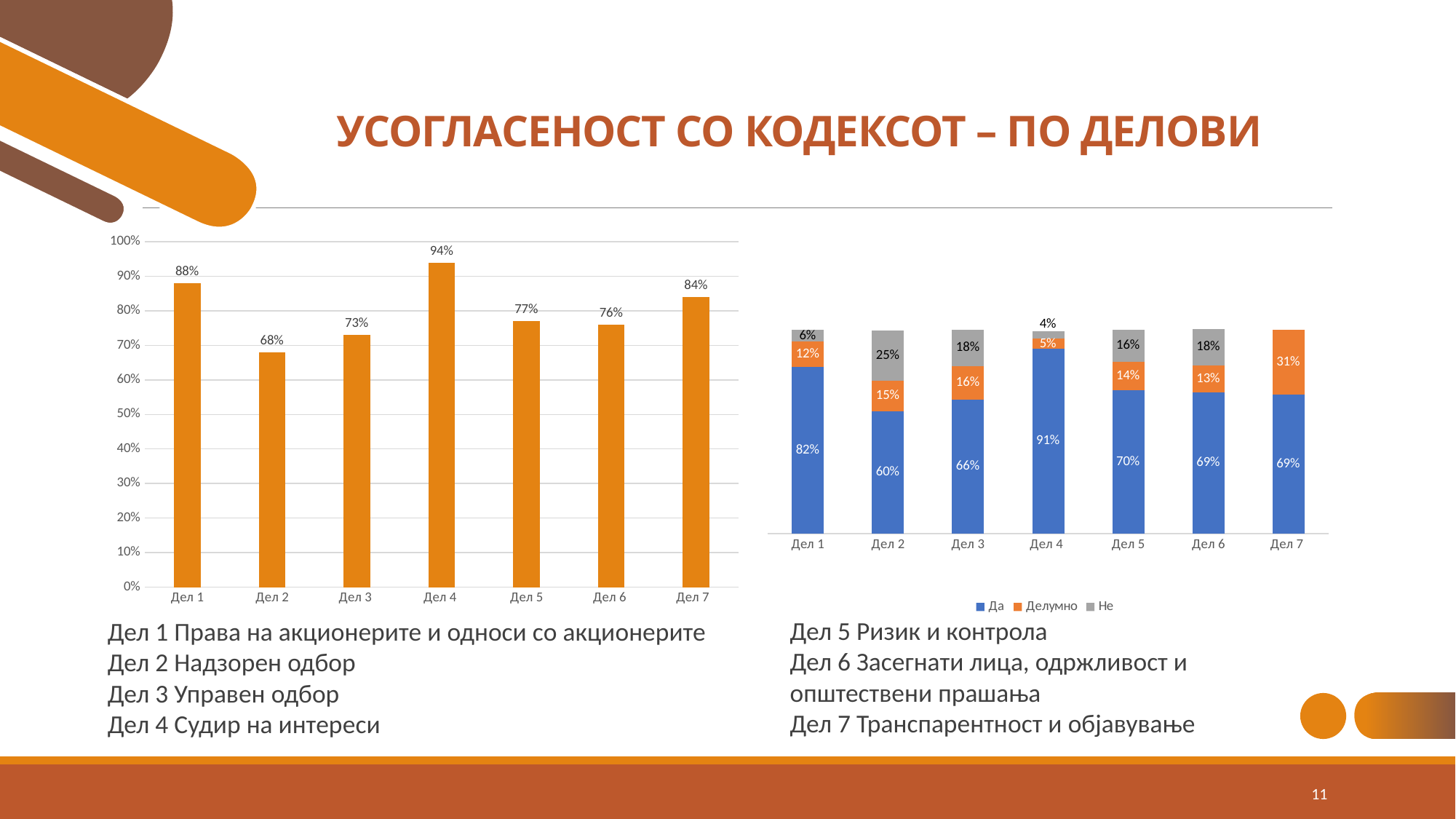
What kind of chart is the chart on the right side of the slide? Stacked bar chart In the right stacked bar chart, which category has the highest Да value? Дел 4 In the left bar chart, which category has the lowest value? Дел 2 In the left bar chart, what is the value for Дел 4? 94% In the right stacked bar chart, what is the value of the Да series for Дел 4? 91% In the right stacked bar chart, what is the value of the Делумно series for Дел 7? 31% How many series does the legend of the right stacked bar chart list? 3 In the left bar chart, which category has the highest value? Дел 4 In the left bar chart, which is larger, the value for Дел 3 or the value for Дел 7? Дел 7 In the right stacked bar chart, what is the value of the Не series for Дел 2? 25% How many categories are shown in the left bar chart? 7 In the left bar chart, what is the difference between the values for Дел 1 and Дел 2? 20%